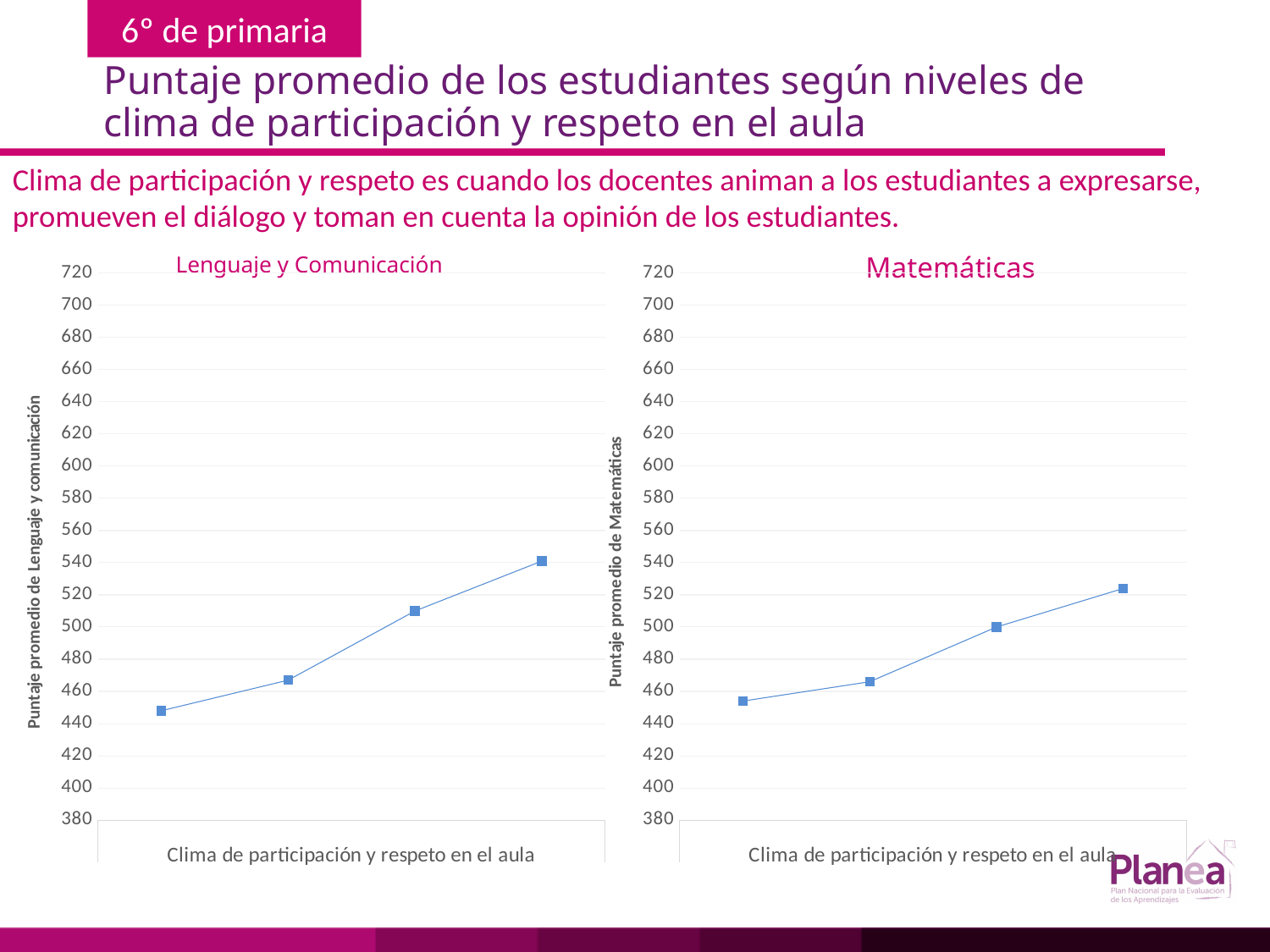
How many data points are plotted on the Matemáticas chart? 4 Which chart has the higher rightmost point, Lenguaje y Comunicación or Matemáticas? Lenguaje y Comunicación On the Lenguaje y Comunicación chart, which point has the highest value, the leftmost or the rightmost? rightmost What is the y-axis label on the Lenguaje y Comunicación chart? Puntaje promedio de Lenguaje y comunicación On the Lenguaje y Comunicación chart, is the value of the rightmost point greater or less than 520? greater On the Matemáticas chart, do the values rise or fall from left to right? rise What kind of chart is the Lenguaje y Comunicación chart? line chart What is the x-axis label on the Matemáticas chart? Clima de participación y respeto en el aula On the Lenguaje y Comunicación chart, is the value of the leftmost point greater or less than 460? less On the Lenguaje y Comunicación chart, do the values rise or fall from left to right? rise On the Matemáticas chart, is the value of the leftmost point greater or less than 480? less